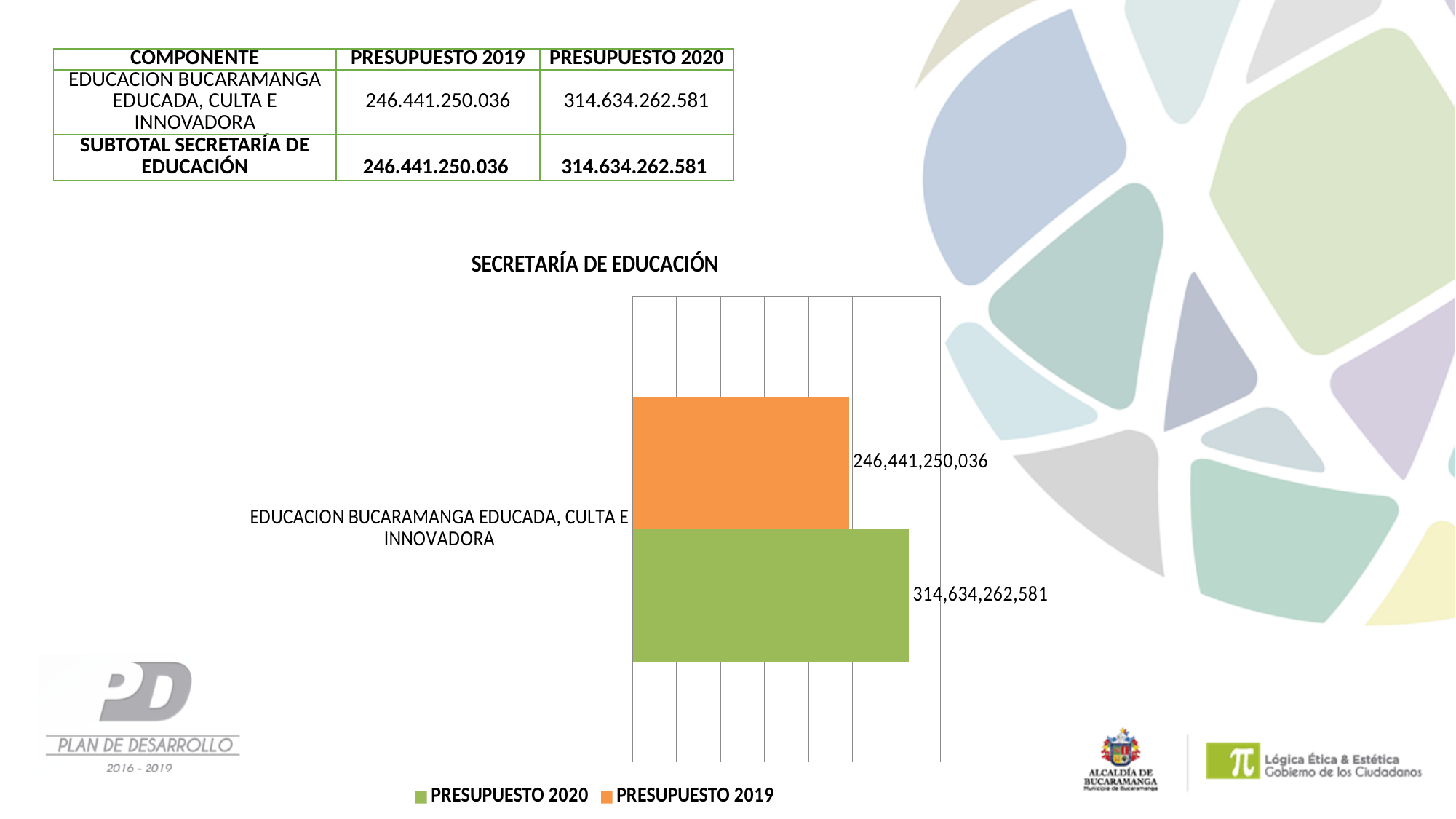
What is the PRESUPUESTO 2020 value for EDUCACION BUCARAMANGA EDUCADA, CULTA E INNOVADORA in the chart? 314,634,262,581 Which series has the larger value in the chart, PRESUPUESTO 2019 or PRESUPUESTO 2020? PRESUPUESTO 2020 Did the budget for EDUCACION BUCARAMANGA EDUCADA, CULTA E INNOVADORA rise or fall from 2019 to 2020 according to the chart? Rise What is the title of the chart? SECRETARÍA DE EDUCACIÓN Which series has the smaller value in the chart? PRESUPUESTO 2019 What type of chart is shown under the title SECRETARÍA DE EDUCACIÓN? Bar chart What is the difference between the PRESUPUESTO 2020 and PRESUPUESTO 2019 values in the chart? 68,193,012,545 How many categories are plotted in the chart? 1 How many series does the chart legend list? 2 What is the PRESUPUESTO 2019 value for EDUCACION BUCARAMANGA EDUCADA, CULTA E INNOVADORA in the chart? 246,441,250,036 Which colour represents PRESUPUESTO 2020 in the chart? Green